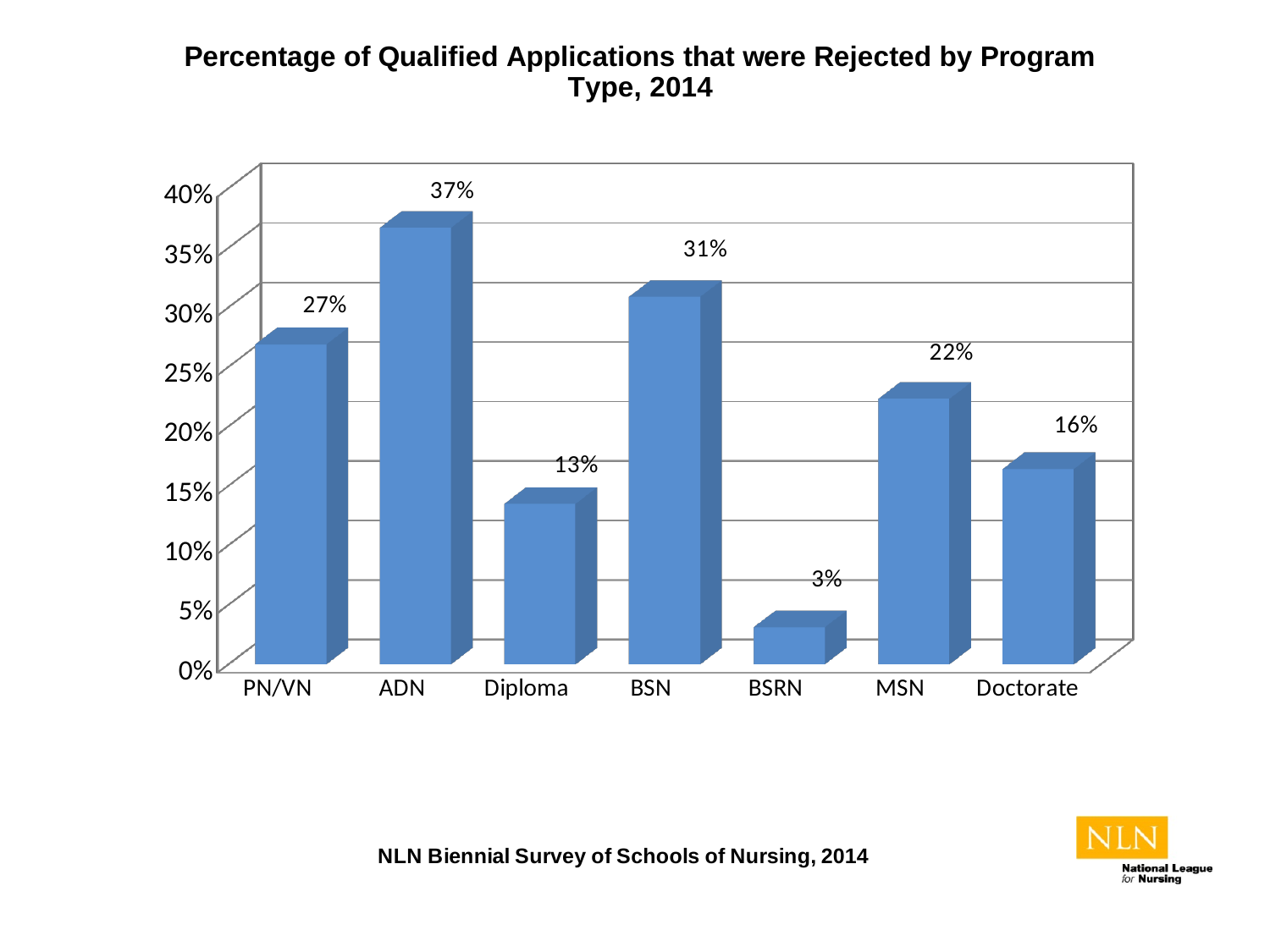
Which program type has the highest percentage of qualified applications rejected? ADN What is the difference between the percentages for ADN and BSN? 6% Which has a higher rejection percentage, Diploma or MSN? MSN What is the value shown for BSRN? 3% Which program type has the lowest percentage of qualified applications rejected? BSRN How many program types are shown on the chart? 7 What is the source cited below the chart? NLN Biennial Survey of Schools of Nursing, 2014 What is the difference between the percentages for PN/VN and Doctorate? 11% What kind of chart is shown on the slide? Bar chart Is the value for BSN greater or less than 25%? greater What percentage of qualified applications were rejected for ADN programs? 37% What percentage is shown for MSN programs? 22%